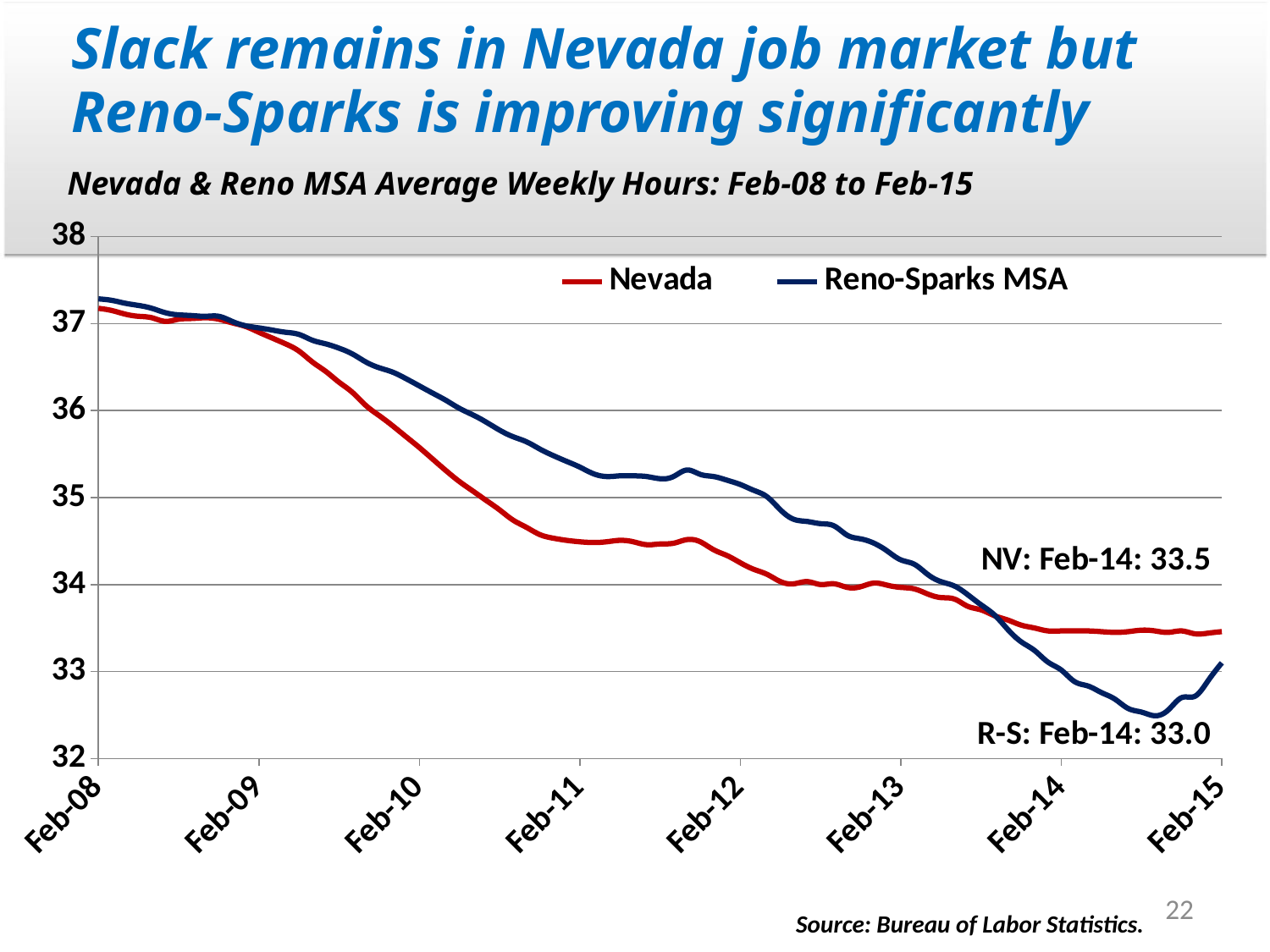
Do the average weekly hours generally rise or fall from Feb-08 to Feb-15? fall What is the difference between the Nevada and Reno-Sparks MSA values labelled for Feb-14? 0.5 At Feb-14, which series has the higher value, Nevada or Reno-Sparks MSA? Nevada Is the value for Nevada at Feb-08 greater or less than 37? greater How many date labels are shown on the x axis? 8 What colour is the line for Reno-Sparks MSA? blue Is the value for Reno-Sparks MSA at Feb-11 greater or less than 35? greater What kind of chart is shown on the slide? line chart What is the Reno-Sparks MSA average weekly hours value labelled for Feb-14? 33.0 Is the value for Nevada at Feb-12 greater or less than 34? greater What is the Nevada average weekly hours value labelled for Feb-14? 33.5 How many series does the legend list? 2